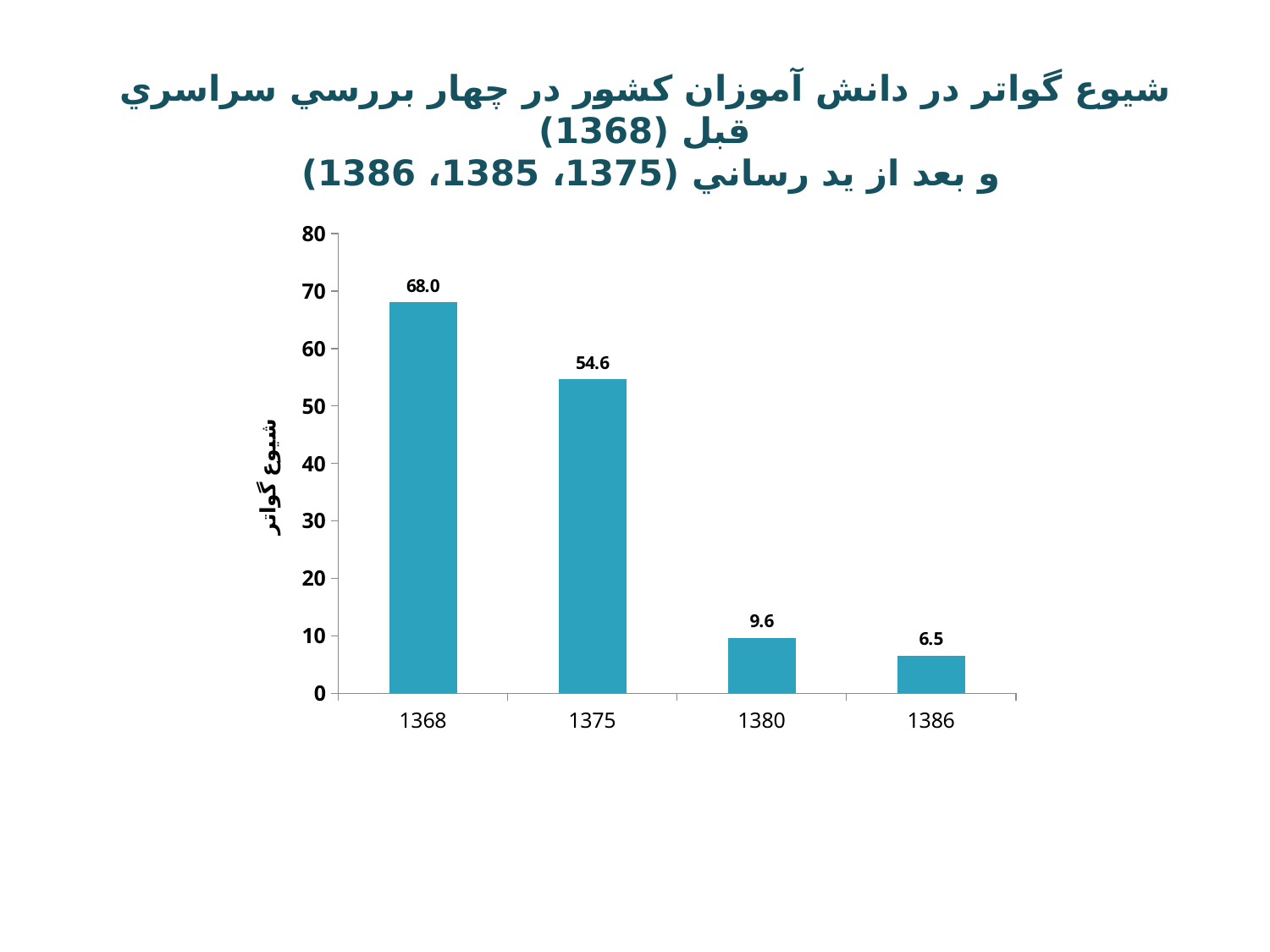
What is the value for 1386? 6.5 Which year has the lowest value? 1386 What is the value for 1375? 54.6 How many years are shown on the x axis? 4 What is the difference between the values for 1368 and 1375? 13.4 What is the value for 1368? 68.0 What is the difference between the values for 1380 and 1386? 3.1 Is the value for 1375 greater or less than 50? greater What is the value for 1380? 9.6 What kind of chart is shown on the slide? bar chart Which year has the highest value? 1368 Which is larger, the value for 1375 or the value for 1380? 1375